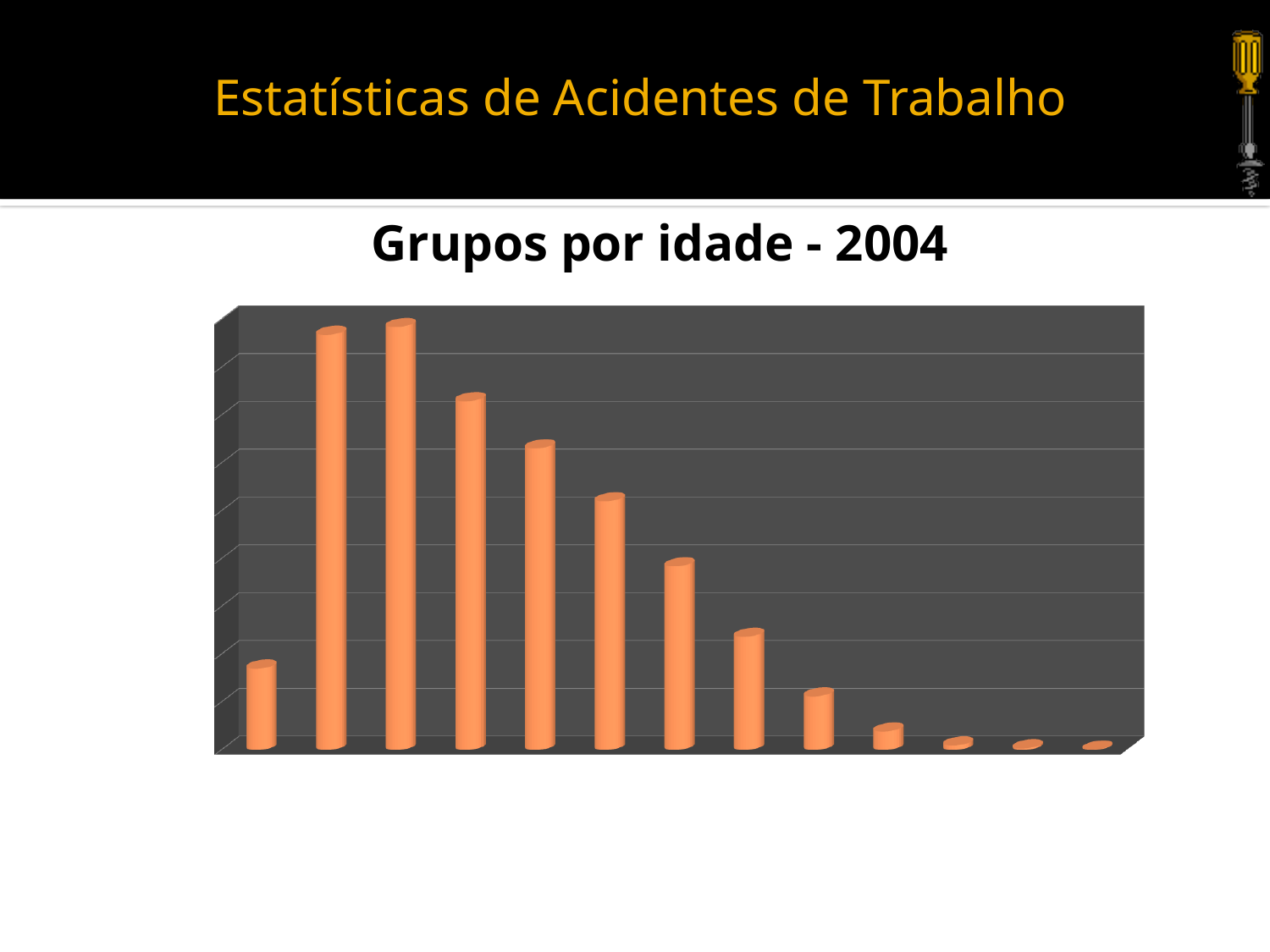
Is the first bar from the left taller or shorter than the second bar from the left? Shorter What kind of chart is shown on the slide? Bar chart Which is larger, the sixth bar from the left or the seventh bar from the left? The sixth bar What is the title of the chart? Grupos por idade - 2004 Which is larger, the fourth bar from the left or the fifth bar from the left? The fourth bar What colour are the bars in the chart? Orange How many bars are plotted in the chart? 13 From the third bar onward to the last bar, do the values rise or fall? Fall